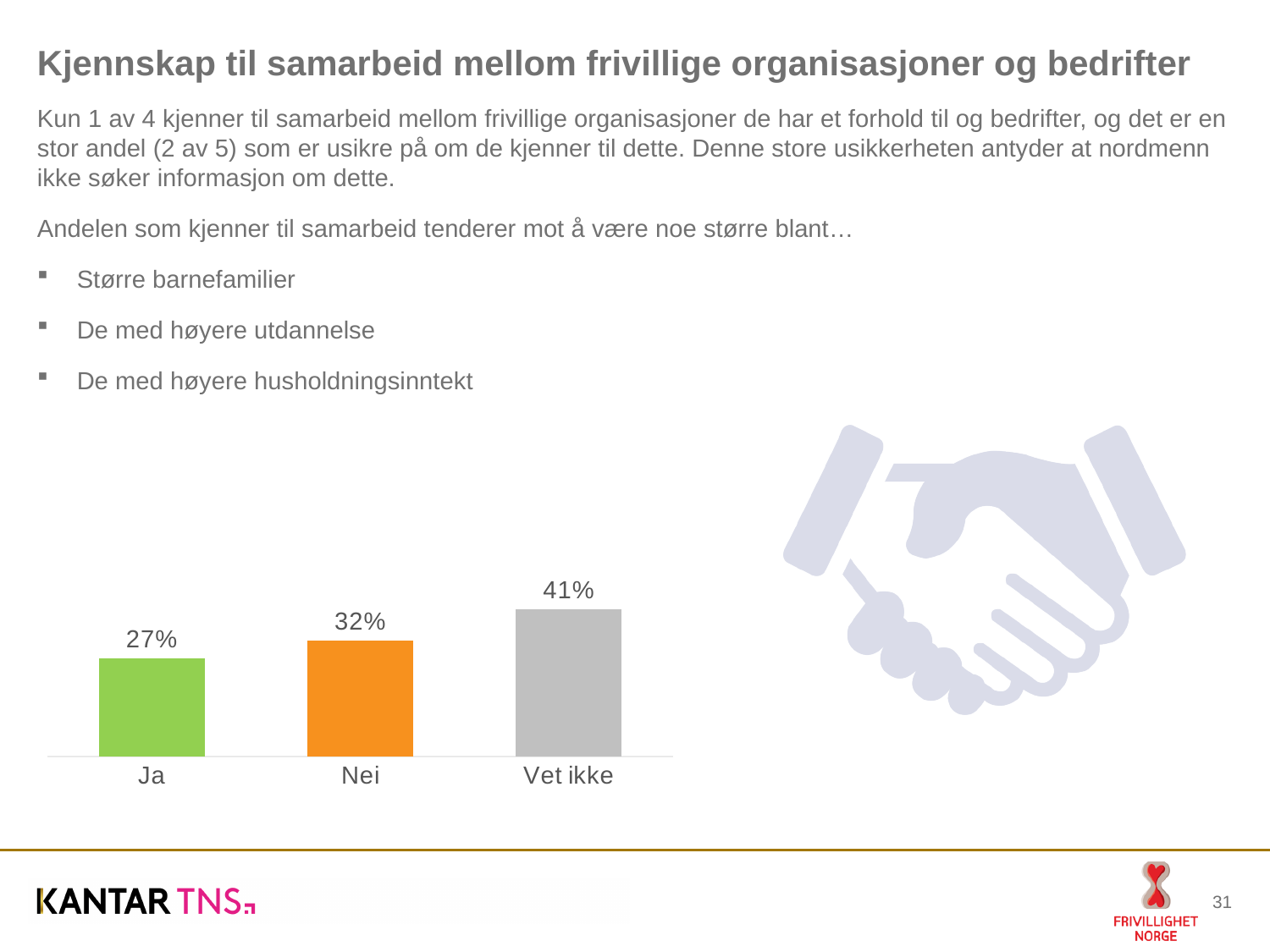
What is the value for "Vet ikke"? 41% What is the value for "Nei"? 32% What colour is the bar for "Ja"? Green What is the difference between the values for "Nei" and "Ja"? 5% Which is larger, the value for "Nei" or the value for "Ja"? Nei How many categories are shown in the chart? 3 What kind of chart is shown on the slide? Bar chart What is the value for "Ja"? 27% Which category has the highest value? Vet ikke Which category has the lowest value? Ja Do the values rise or fall from left to right across the categories? Rise What is the difference between the values for "Vet ikke" and "Ja"? 14%